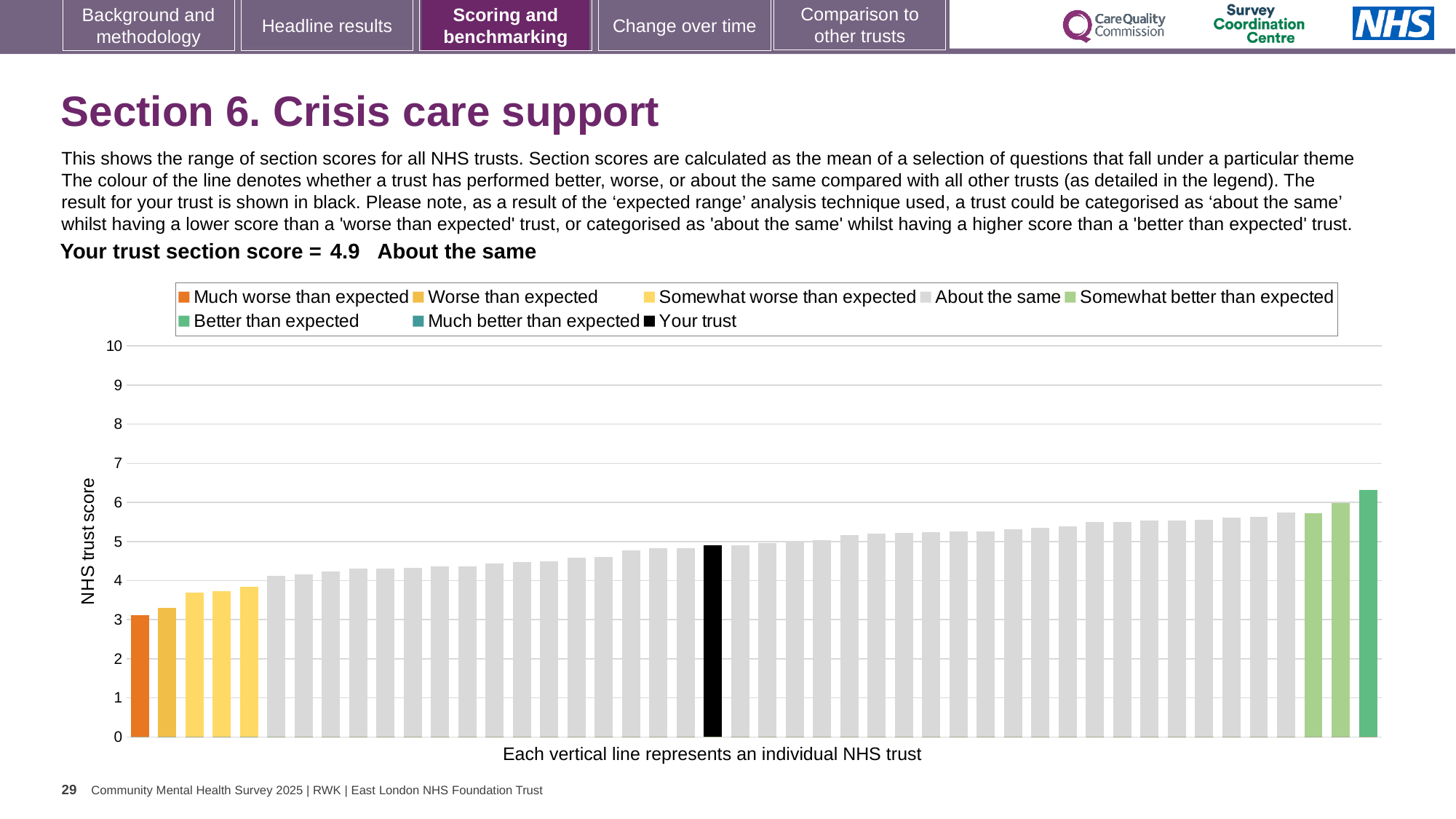
What kind of chart is shown on the slide? bar chart How many bars are coloured as 'Much worse than expected'? 1 How many bars are coloured as 'Somewhat worse than expected'? 3 What colour is the bar representing your trust? black Do the trust scores rise or fall from left to right along the x axis? rise How many entries does the chart legend list? 8 Which performance category is your trust placed in for Section 6? About the same Is the value of the highest bar (Better than expected) greater or less than 6? greater Is the value of the lowest bar (Much worse than expected) greater or less than 4? less What is the label on the vertical axis of the chart? NHS trust score How many bars are coloured as 'Somewhat better than expected'? 2 What is the section score for your trust shown on the slide? 4.9